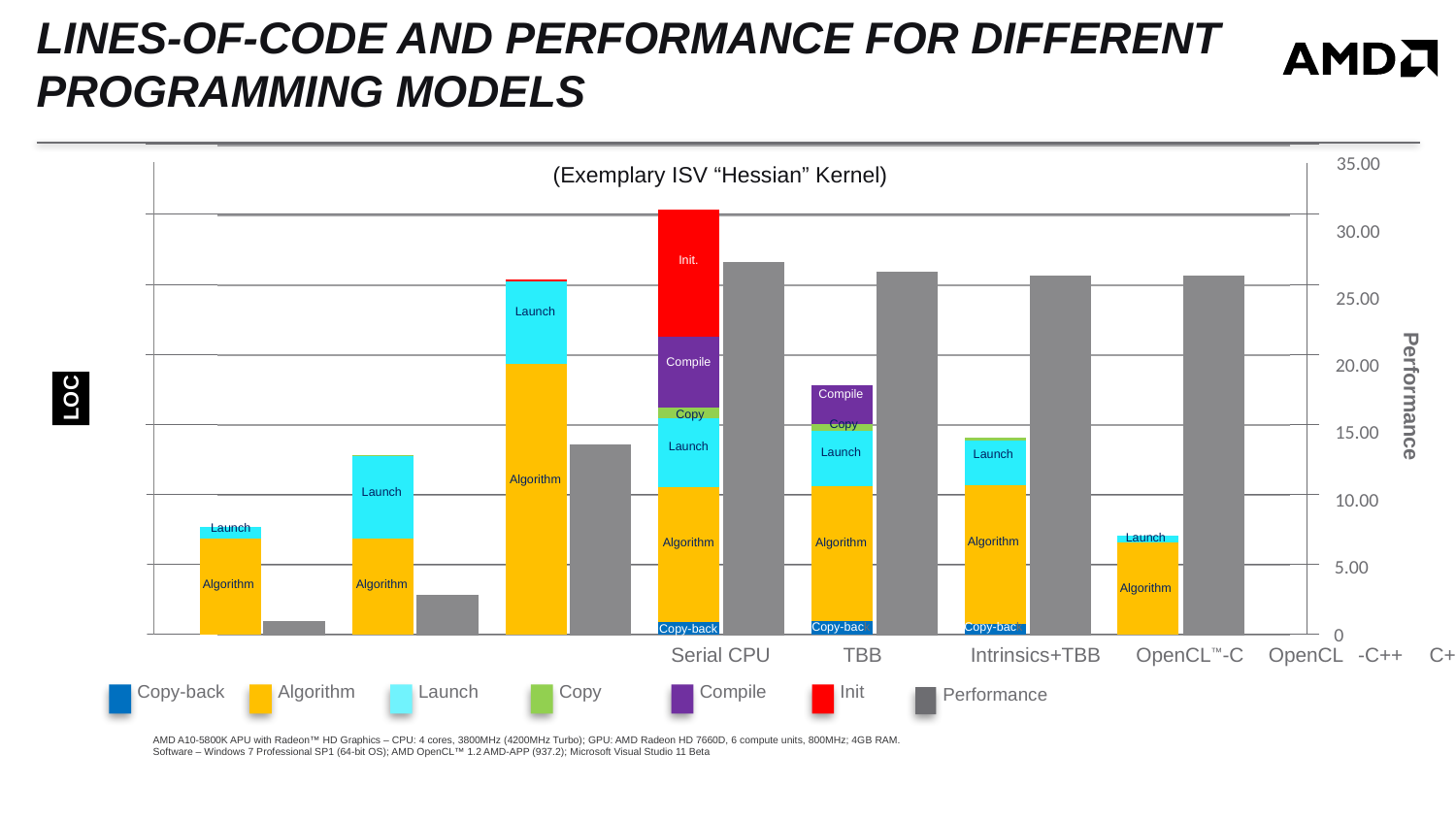
Which group of bars has the tallest stacked LOC bar? the fourth group from the left Which legend entry is shown in red? Init How many groups of bars are plotted along the x axis? 7 What kind of chart is shown on the slide? bar chart Which group of bars has the lowest gray Performance bar? the first (leftmost) group What is the subtitle shown inside the chart area? (Exemplary ISV "Hessian" Kernel) Is the gray Performance bar in the first (leftmost) group greater or less than 5.00 on the right axis? less How many series does the legend list? 7 Is the gray Performance bar in the third group from the left greater or less than 10.00 on the right axis? greater Is the gray Performance bar in the second group from the left greater or less than 5.00 on the right axis? less Is the gray Performance bar in the fourth group taller or shorter than the gray Performance bar in the first group? taller